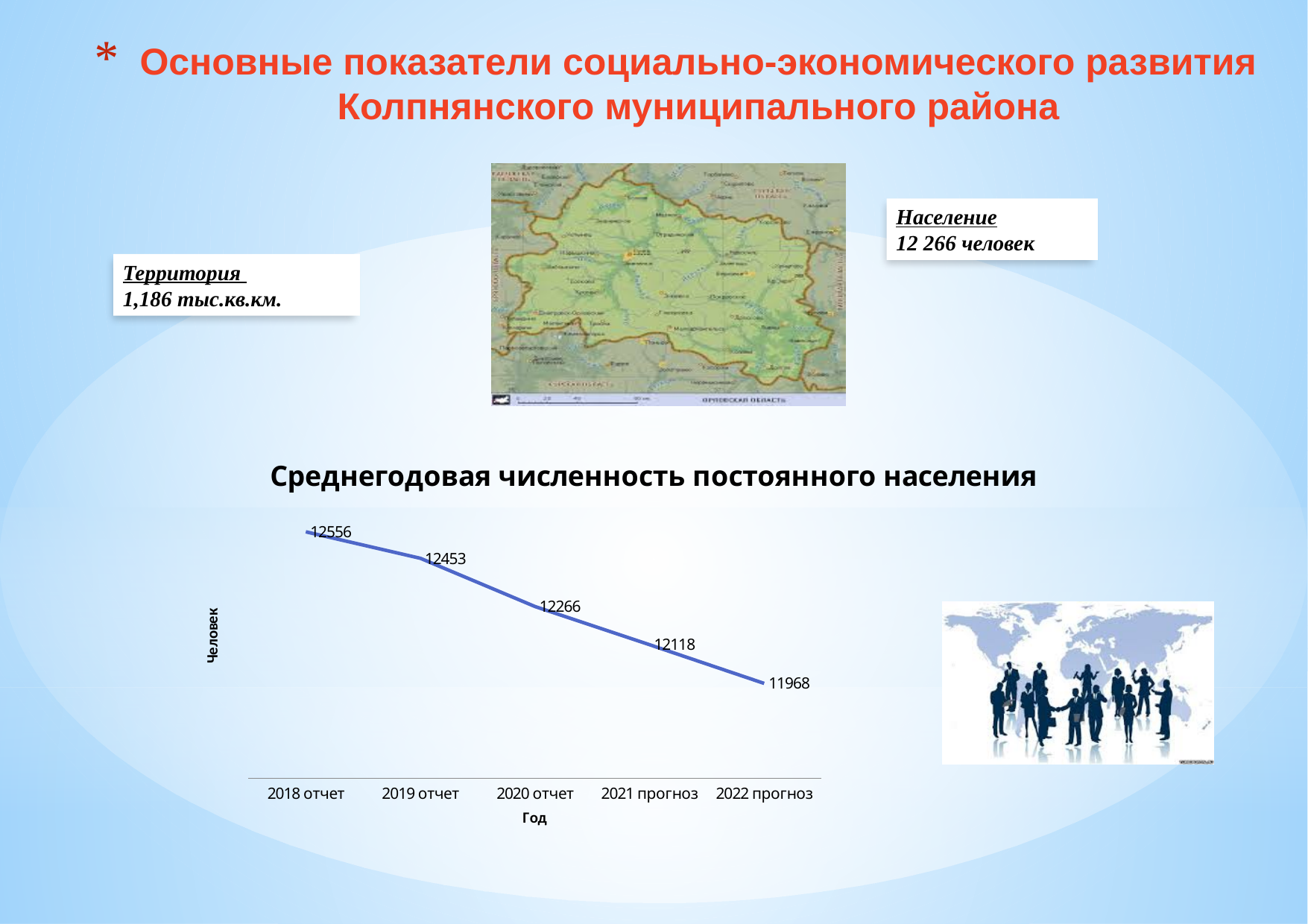
Which year has the highest value in the chart 'Среднегодовая численность постоянного населения'? 2018 отчет What is the value for 2021 прогноз in the chart 'Среднегодовая численность постоянного населения'? 12118 Do the values in the chart 'Среднегодовая численность постоянного населения' rise or fall from 2018 to 2022? fall Which is larger in the chart 'Среднегодовая численность постоянного населения': the value for 2019 отчет or 2021 прогноз? 2019 отчет How many data points are plotted in the chart 'Среднегодовая численность постоянного населения'? 5 What kind of chart is 'Среднегодовая численность постоянного населения'? line chart What is the difference between the values for 2019 отчет and 2020 отчет in the chart 'Среднегодовая численность постоянного населения'? 187 What is the difference between the values for 2018 отчет and 2022 прогноз in the chart 'Среднегодовая численность постоянного населения'? 588 What is the value for 2020 отчет in the chart 'Среднегодовая численность постоянного населения'? 12266 Which year has the lowest value in the chart 'Среднегодовая численность постоянного населения'? 2022 прогноз What is the value for 2022 прогноз in the chart 'Среднегодовая численность постоянного населения'? 11968 What is the value for 2018 отчет in the chart 'Среднегодовая численность постоянного населения'? 12556